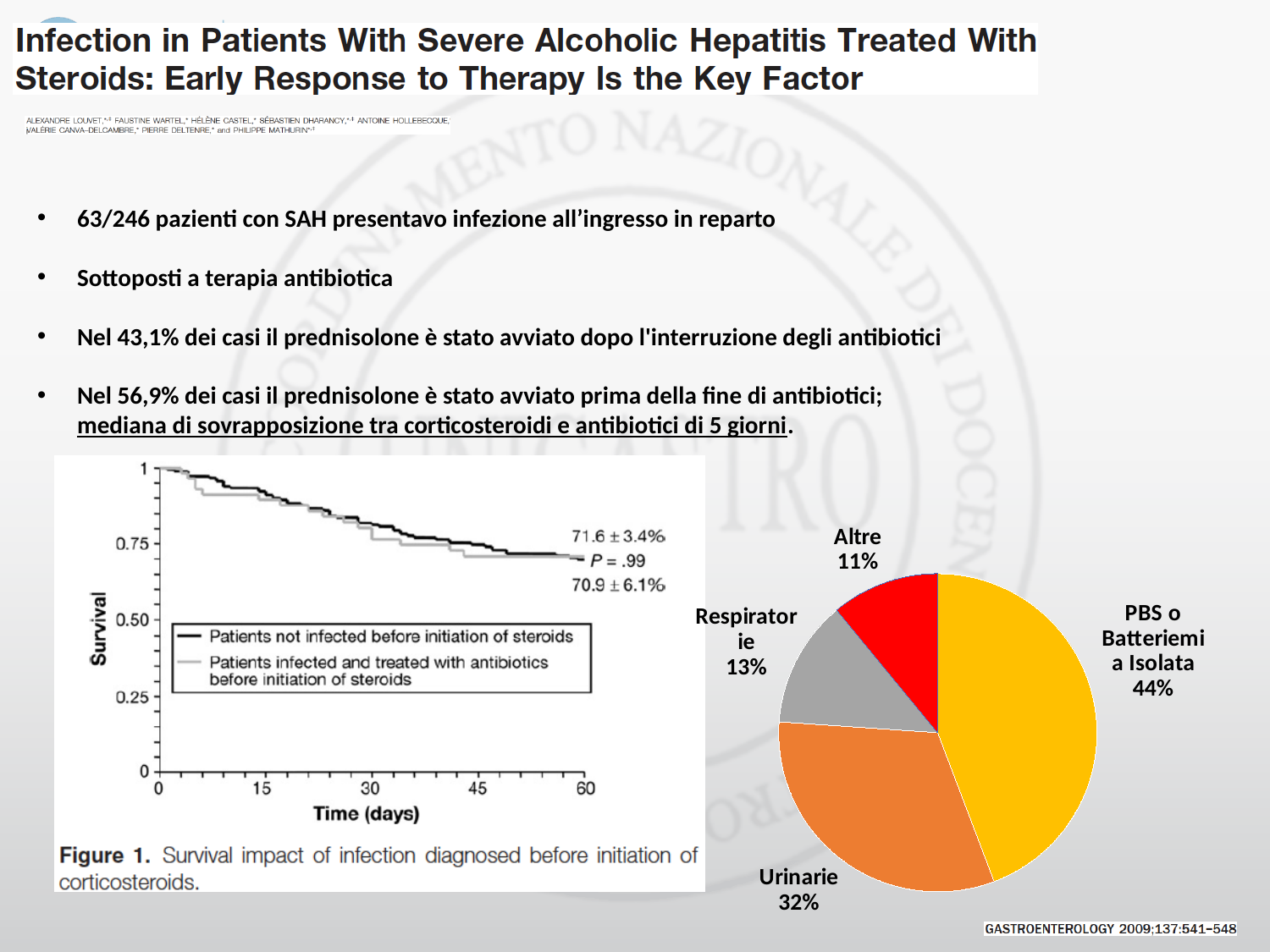
In the pie chart, which category has the largest slice? PBS o Batteriemia Isolata How many slices does the pie chart have? 4 What kind of chart is Figure 1 on the left of the slide? Line chart In the pie chart, what is the difference in percentage points between Urinarie and Respiratorie? 19 percentage points In Figure 1, do the survival curves rise or fall as time increases? Fall How many series does the legend of Figure 1 list? 2 In the pie chart, what share is labelled for Urinarie? 32% In the pie chart, what share is labelled for Respiratorie? 13% In Figure 1, what is the P value printed on the chart? P = .99 What kind of chart is the chart on the right of the slide? Pie chart In the pie chart, which is larger, Respiratorie or Altre? Respiratorie In the pie chart, which category has the smallest slice? Altre